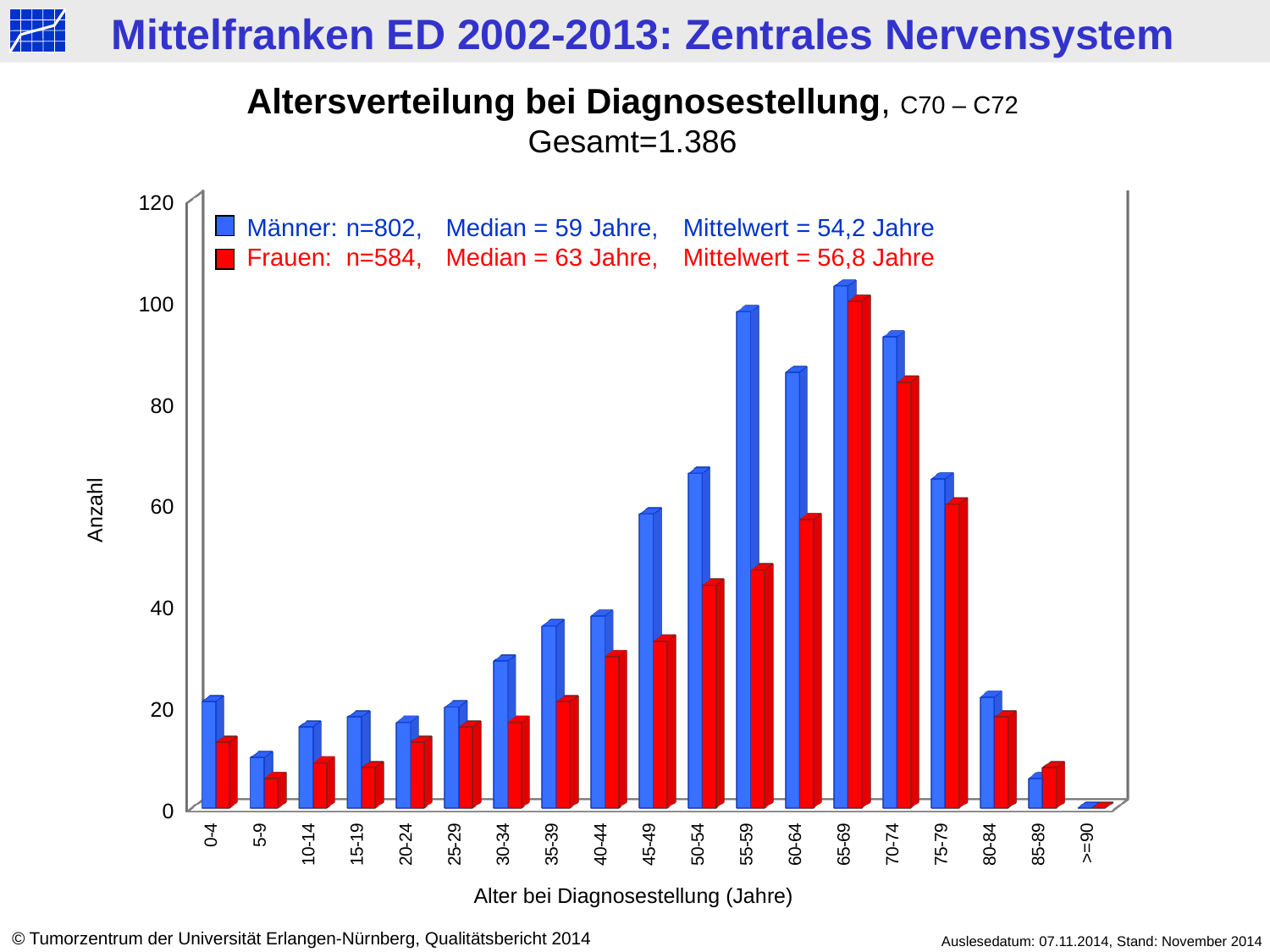
Is the value for Männer in the 30-34 age group greater or less than 20? greater Which age group has the lowest value for Männer? >=90 According to the legend, what is the n for Frauen? n=584 How many series does the legend list? 2 In the 55-59 age group, which series has the larger value, Männer or Frauen? Männer What kind of chart is shown on the slide? bar chart Which age group has the highest value for Frauen? 65-69 Is the value for Männer in the 55-59 age group greater or less than 80? greater How many age categories are shown on the x axis? 19 Which age group has the highest value for Männer? 65-69 Is the value for Frauen in the 70-74 age group greater or less than 80? greater In the 85-89 age group, which series has the larger value, Männer or Frauen? Frauen